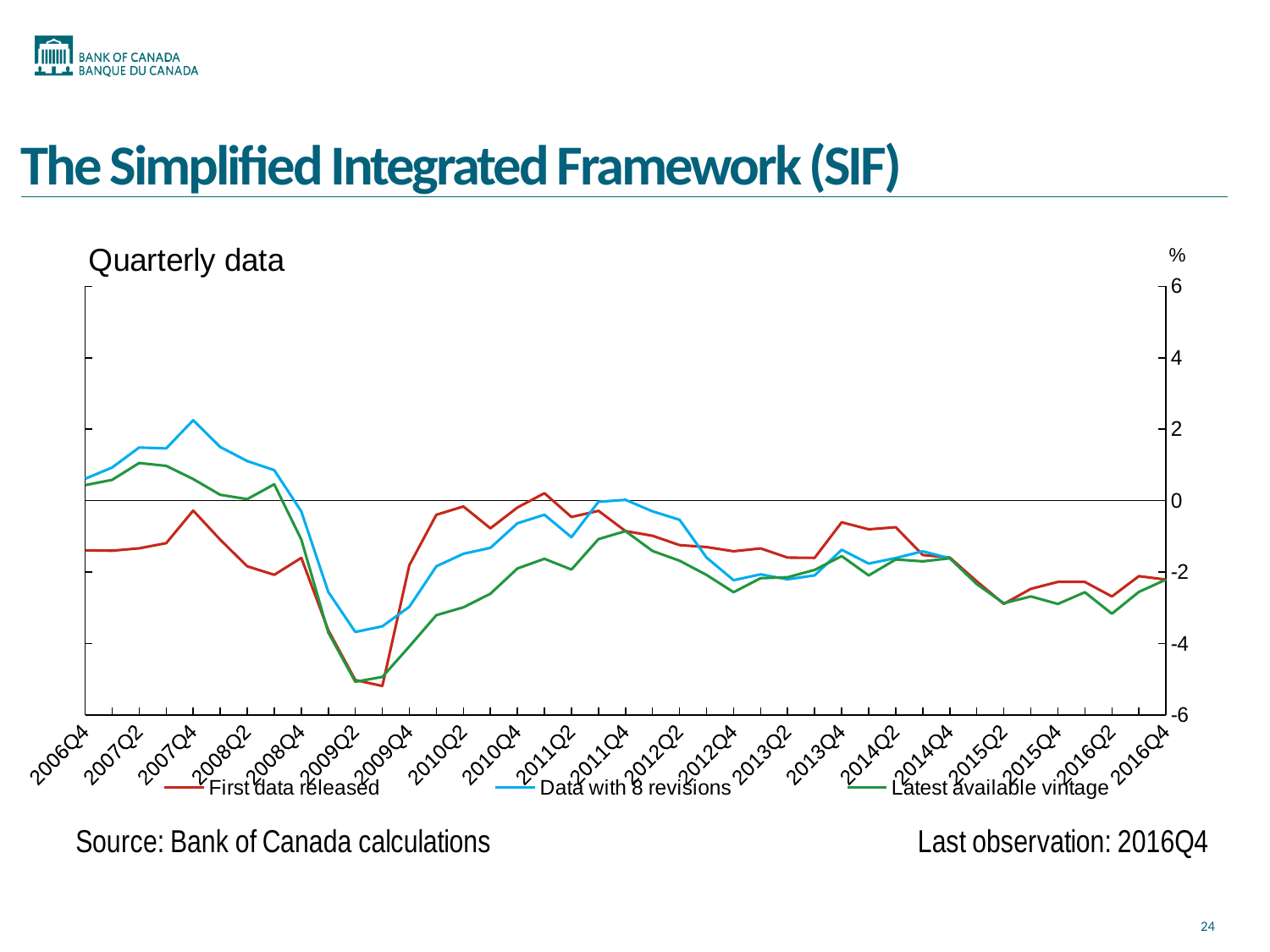
What is the unit shown at the top of the right-hand axis? % Which series reaches the highest value anywhere on the chart? Data with 8 revisions At 2009Q2, which series is higher: Data with 8 revisions or First data released? Data with 8 revisions Is the value for Data with 8 revisions at 2007Q4 greater or less than 2? greater Is the value for First data released at 2006Q4 greater or less than 0? less Which series is drawn in blue according to the legend? Data with 8 revisions Is the value for Latest available vintage at 2009Q2 greater or less than -4? less What kind of chart is shown on the slide? Line chart At 2007Q4, which series is higher: First data released or Data with 8 revisions? Data with 8 revisions How many series does the legend list? 3 Does the First data released series rise or fall between 2008Q4 and 2009Q2? Fall